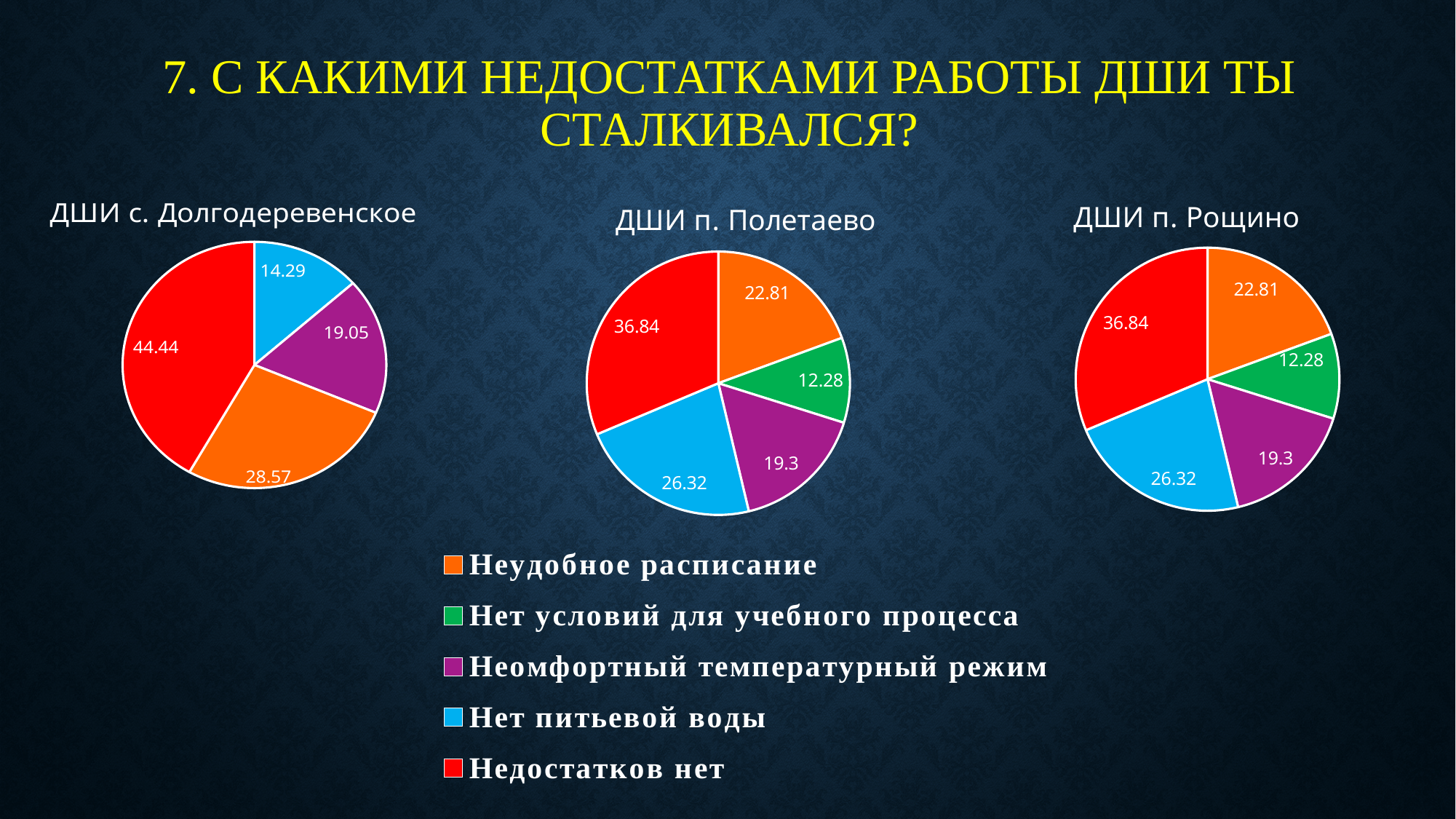
How many slices does the chart titled "ДШИ с. Долгодеревенское" have? 4 In the chart titled "ДШИ п. Рощино", which category has the largest slice? Недостатков нет What type of chart is used on this slide? Pie chart In the chart titled "ДШИ с. Долгодеревенское", what is the value for "Недостатков нет"? 44.44 In the chart titled "ДШИ п. Полетаево", which is larger: "Нет питьевой воды" or "Неомфортный температурный режим"? Нет питьевой воды How many categories does the legend list? 5 In the chart titled "ДШИ п. Рощино", what is the value for "Нет условий для учебного процесса"? 12.28 In the chart titled "ДШИ с. Долгодеревенское", which category has the largest slice? Недостатков нет In the chart titled "ДШИ п. Полетаево", which category has the smallest slice? Нет условий для учебного процесса In the chart titled "ДШИ п. Полетаево", what is the value for "Неудобное расписание"? 22.81